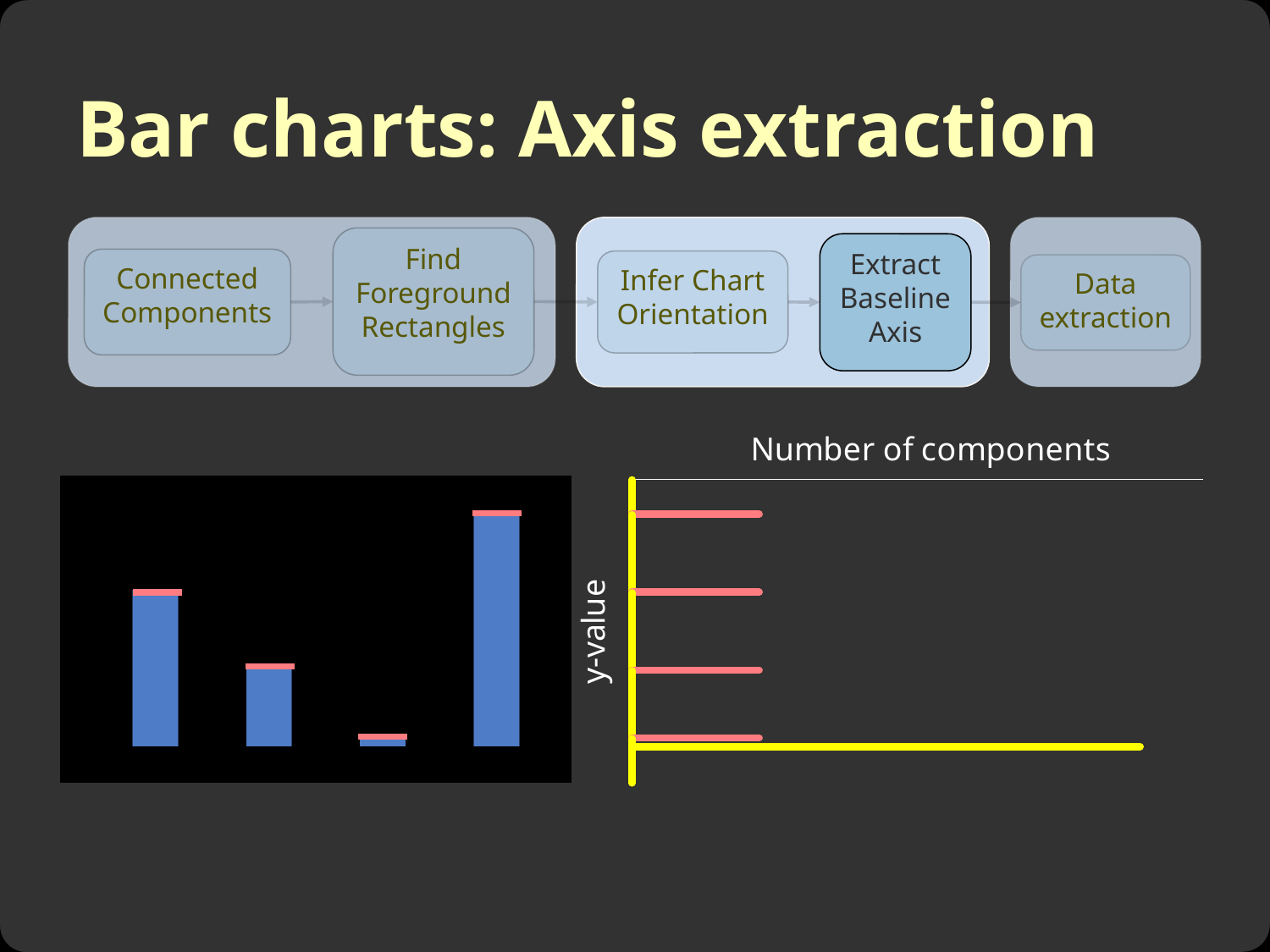
In the bar chart on the left, is the second bar taller or shorter than the fourth bar? shorter In the bar chart on the left, do the bar heights consistently rise or fall from left to right? neither; they fall for the first three bars and then rise sharply at the fourth In the bar chart on the left, which bar is the tallest? the fourth (rightmost) bar What is the horizontal axis label of the diagram on the right of the slide? Number of components In the bar chart on the left, is the first bar taller or shorter than the second bar? taller In the bar chart on the left, which bar is the shortest? the third bar How many bars does the bar chart on the left of the slide contain? 4 What is the vertical axis label of the diagram on the right of the slide? y-value What kind of chart is shown on the left of the slide? bar chart